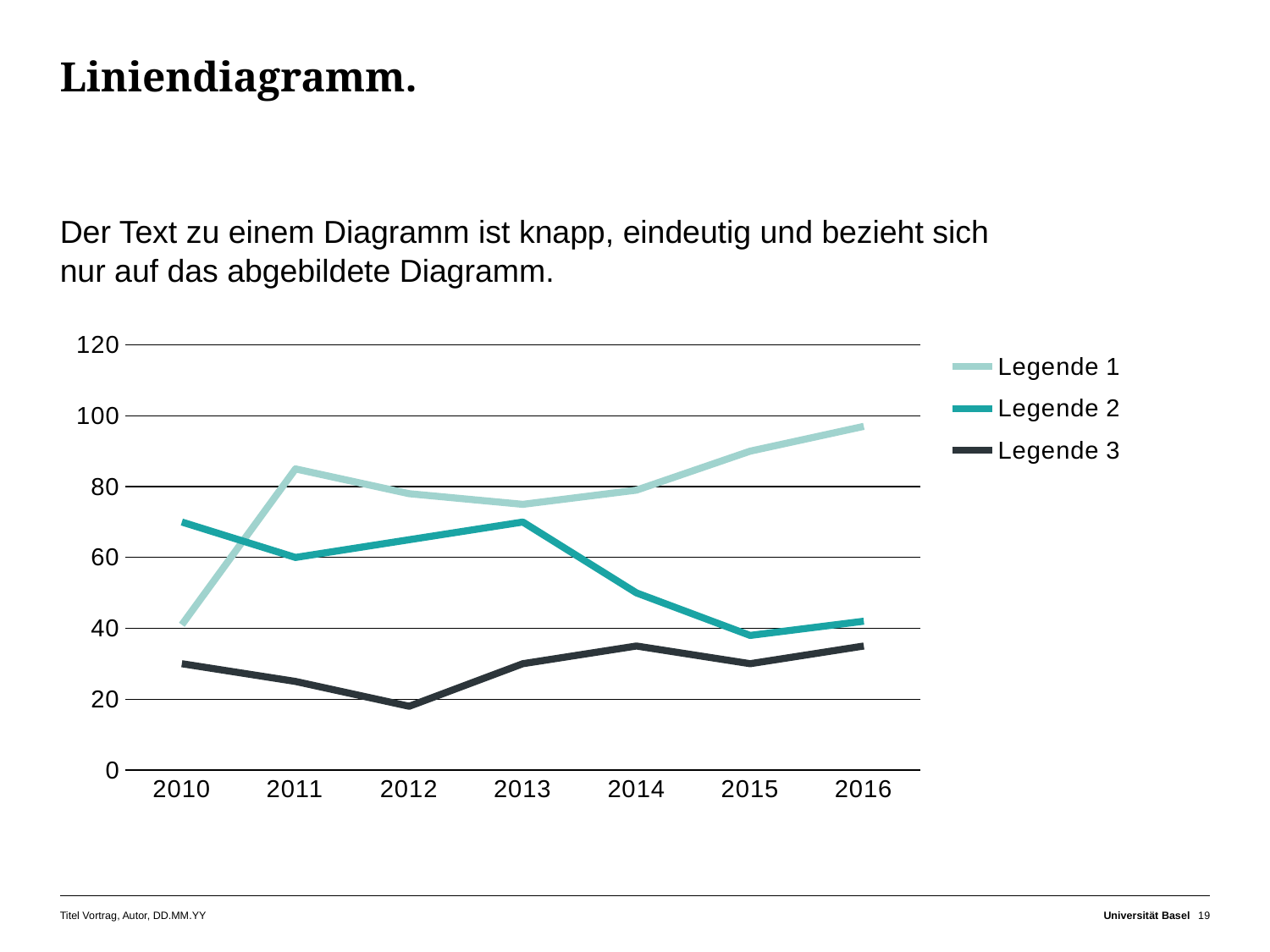
Which series has the lowest value in 2013? Legende 3 How many series does the legend list? 3 In 2010, which is larger: Legende 1 or Legende 2? Legende 2 Does Legende 1 rise or fall from 2013 to 2016? rise What is the value of Legende 2 in 2011? 60 Is the value for Legende 1 in 2016 greater or less than 80? greater How many years are shown on the x axis? 7 What kind of chart is shown on the slide? line chart Is the value for Legende 3 in 2012 greater or less than 40? less Which series has the highest value in 2016? Legende 1 Is the value for Legende 1 in 2010 greater or less than 60? less